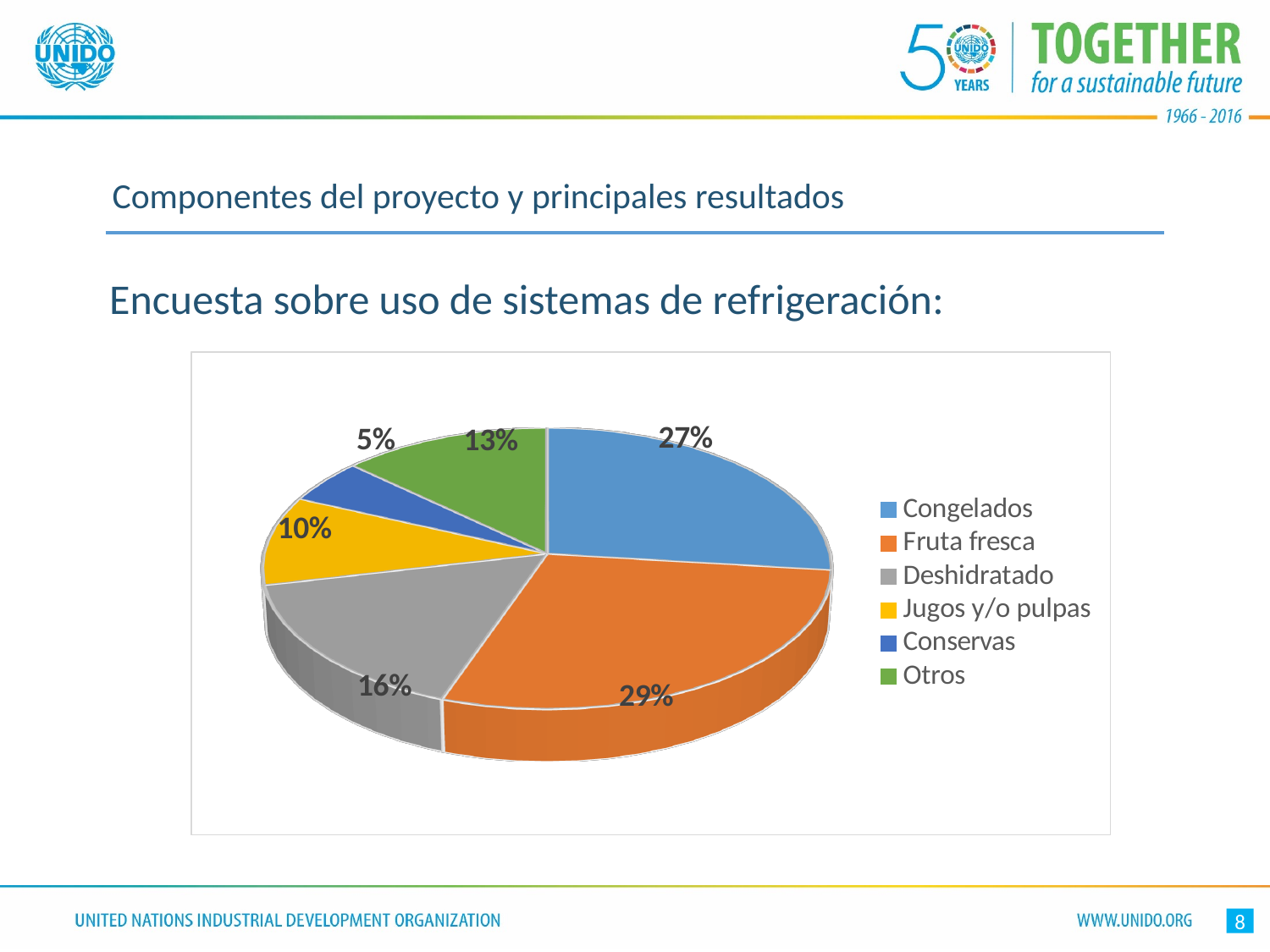
What share of the pie does Congelados represent? 27% Which category has the smallest share of the pie? Conservas Which category has the largest share of the pie? Fruta fresca What kind of chart is shown on the slide? pie chart How many categories does the legend list? 6 What share of the pie does Conservas represent? 5% What share of the pie does Jugos y/o pulpas represent? 10% What share of the pie does Fruta fresca represent? 29% What share of the pie does Otros represent? 13% What share of the pie does Deshidratado represent? 16% Which is larger, the share for Otros or the share for Jugos y/o pulpas? Otros What is the difference in percentage points between Fruta fresca and Deshidratado? 13